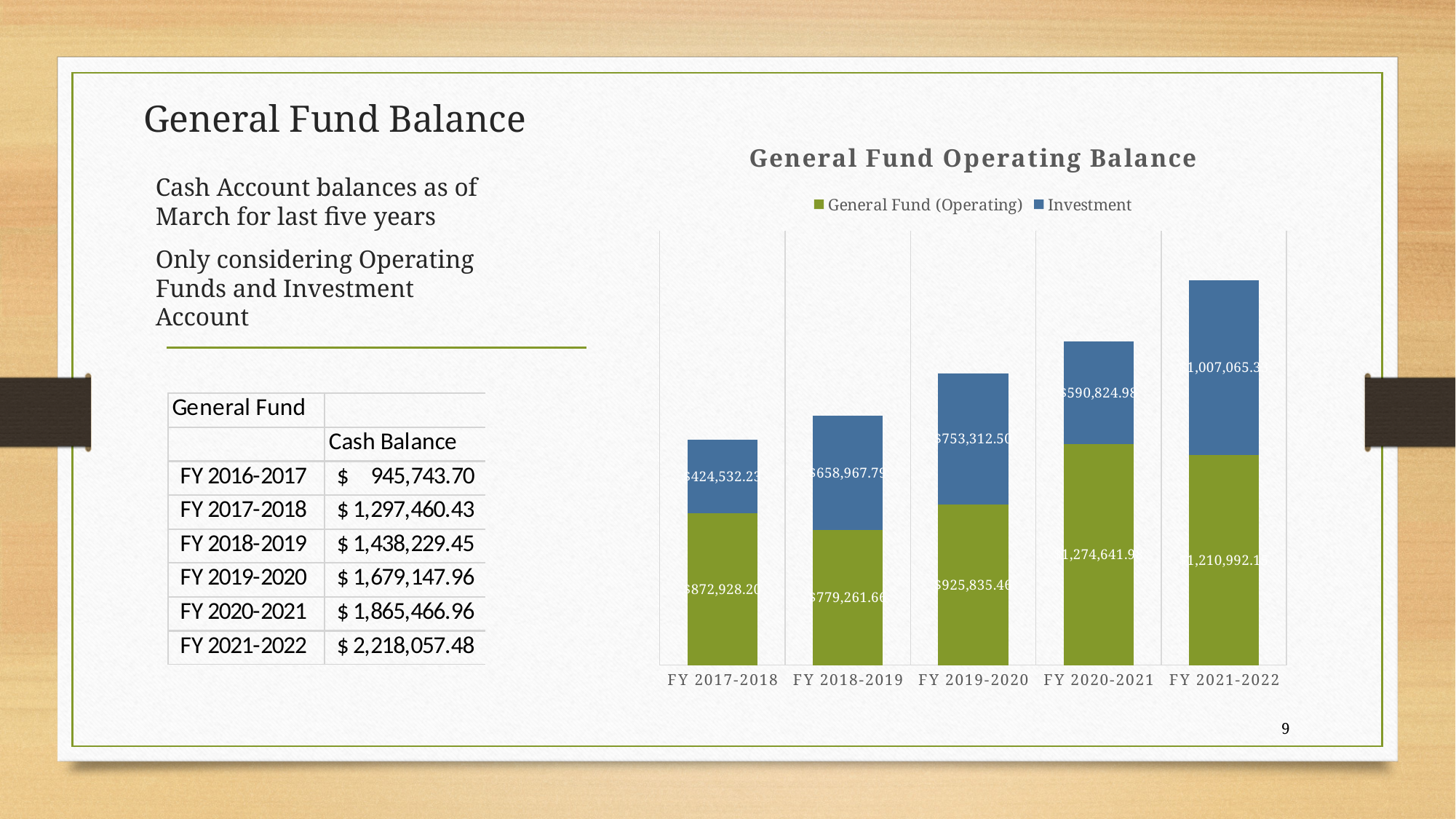
What is the General Fund (Operating) value for FY 2018-2019? $779,261.66 Which fiscal year has the highest Investment value? FY 2021-2022 Do the total stacked bar heights rise or fall from FY 2017-2018 to FY 2021-2022? Rise How many fiscal years are plotted on the x axis of the chart? 5 How many series does the legend of the General Fund Operating Balance chart list? 2 In FY 2019-2020, which is larger: the General Fund (Operating) value or the Investment value? General Fund (Operating) What type of chart is shown on the slide? Stacked bar chart Which fiscal year has the lowest General Fund (Operating) value? FY 2018-2019 What is the Investment value for FY 2020-2021? $590,824.98 What is the Investment value for FY 2019-2020? $753,312.50 How much larger is the Investment value in FY 2019-2020 than in FY 2018-2019? $94,344.71 What is the total of the stacked bar for FY 2018-2019? $1,438,229.45